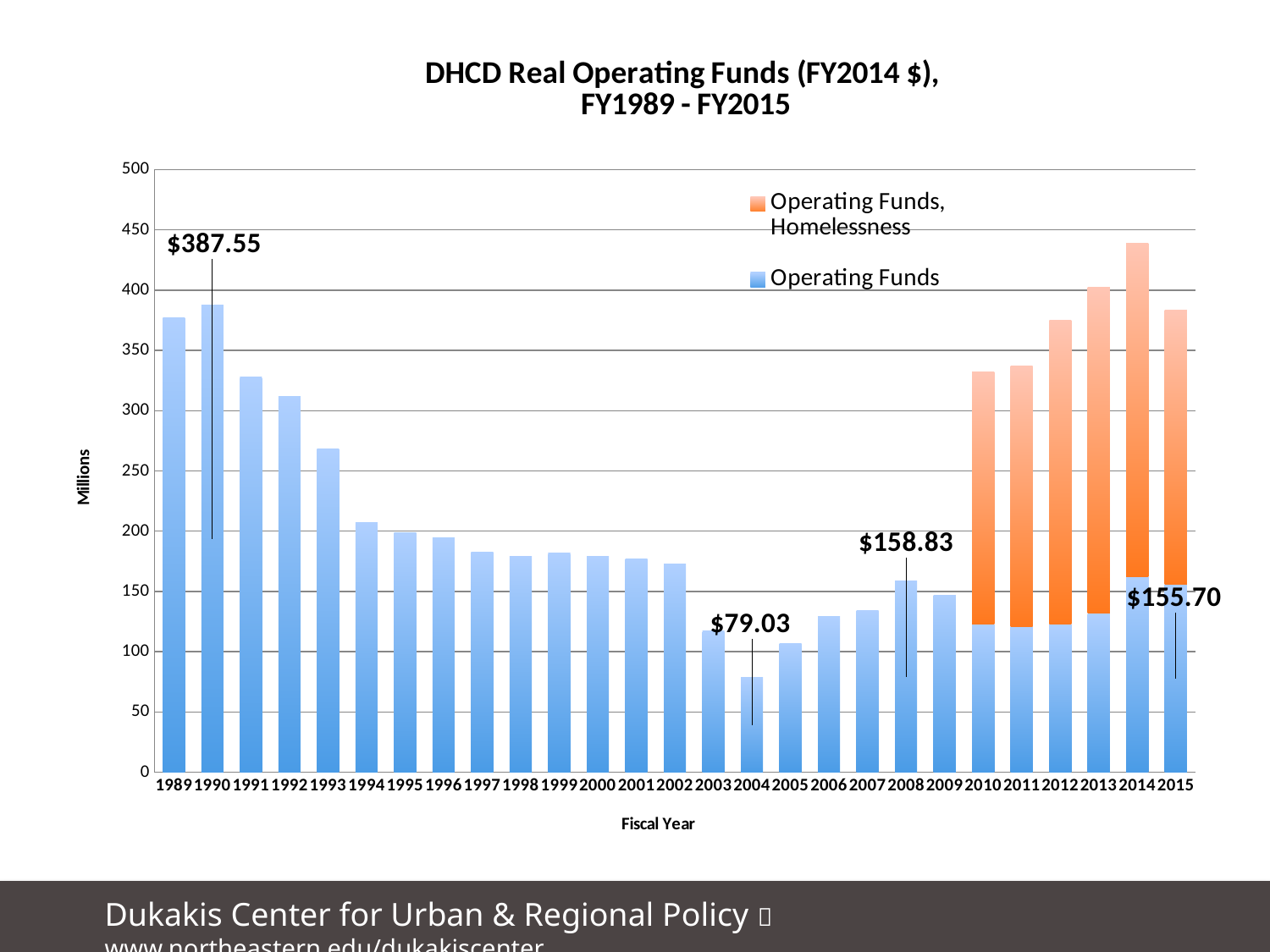
How many fiscal years are shown on the x axis? 27 How many series does the legend list? 2 What is the value of Operating Funds for fiscal year 1990? $387.55 What is the difference between the Operating Funds values for 1990 and 2004? $308.52 What kind of chart is shown on the slide? bar chart Which fiscal year has the lowest Operating Funds value? 2004 What is the value of Operating Funds for fiscal year 2008? $158.83 What is the value of Operating Funds for fiscal year 2004? $79.03 Do the Operating Funds values rise or fall from 1990 to 2004? fall Is the Operating Funds value for 2003 greater or less than 150? less What is the labelled value of Operating Funds for fiscal year 2015? $155.70 Which fiscal year has the tallest total bar? 2014